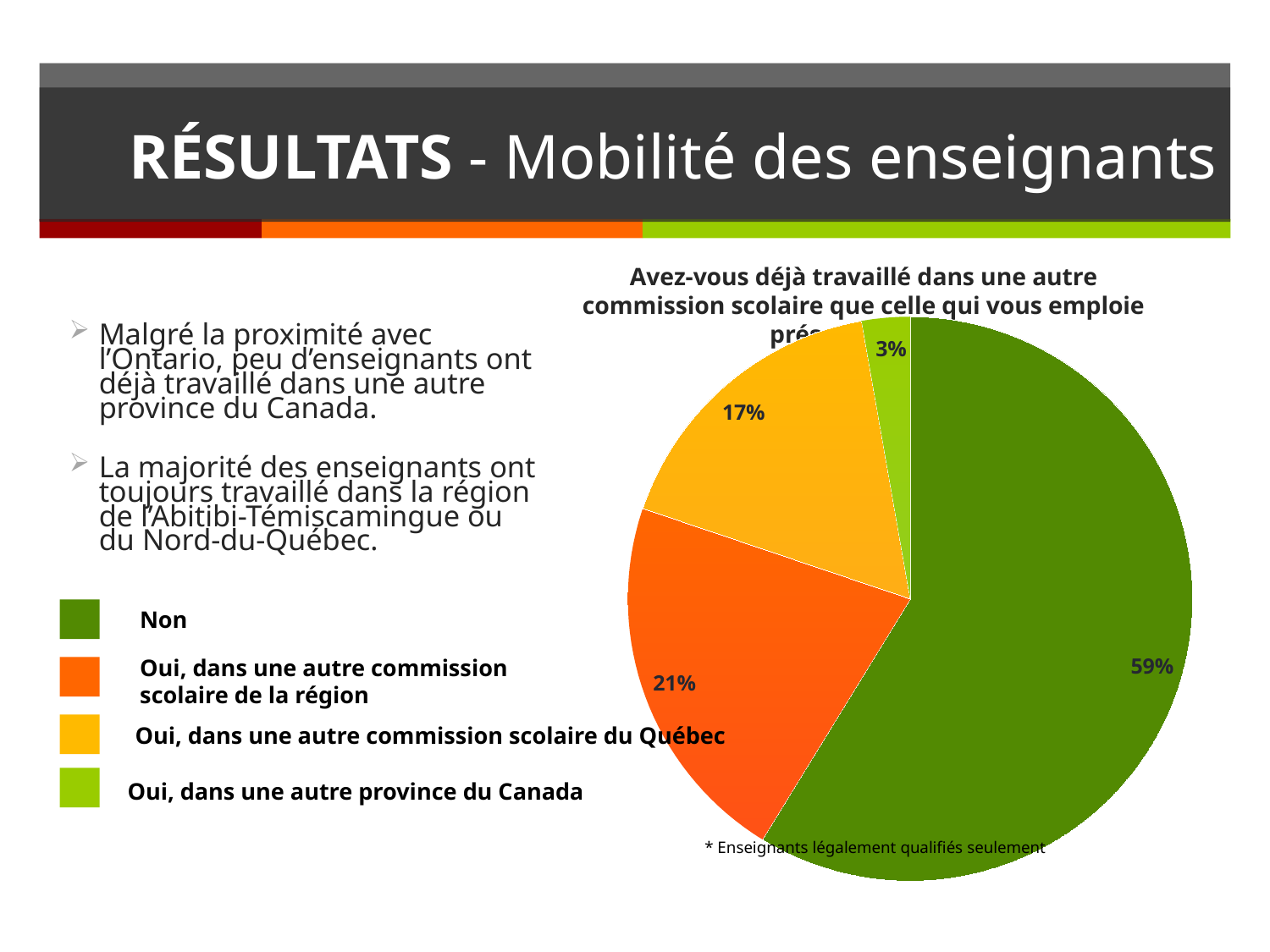
Which category has the smallest slice of the pie? Oui, dans une autre province du Canada What share of the pie corresponds to "Oui, dans une autre commission scolaire du Québec"? 17% What share of the pie corresponds to "Oui, dans une autre commission scolaire de la région"? 21% Which is larger: the slice for "Oui, dans une autre commission scolaire de la région" or the slice for "Oui, dans une autre commission scolaire du Québec"? Oui, dans une autre commission scolaire de la région What colour is the slice representing "Non"? dark green How many slices does the pie chart have? 4 What share of the pie corresponds to "Oui, dans une autre province du Canada"? 3% What footnote appears below the pie chart? * Enseignants légalement qualifiés seulement Which category has the largest slice of the pie? Non What kind of chart is shown on the slide? pie chart What share of the pie corresponds to "Non"? 59% What is the difference in percentage points between the "Non" slice and the "Oui, dans une autre commission scolaire de la région" slice? 38